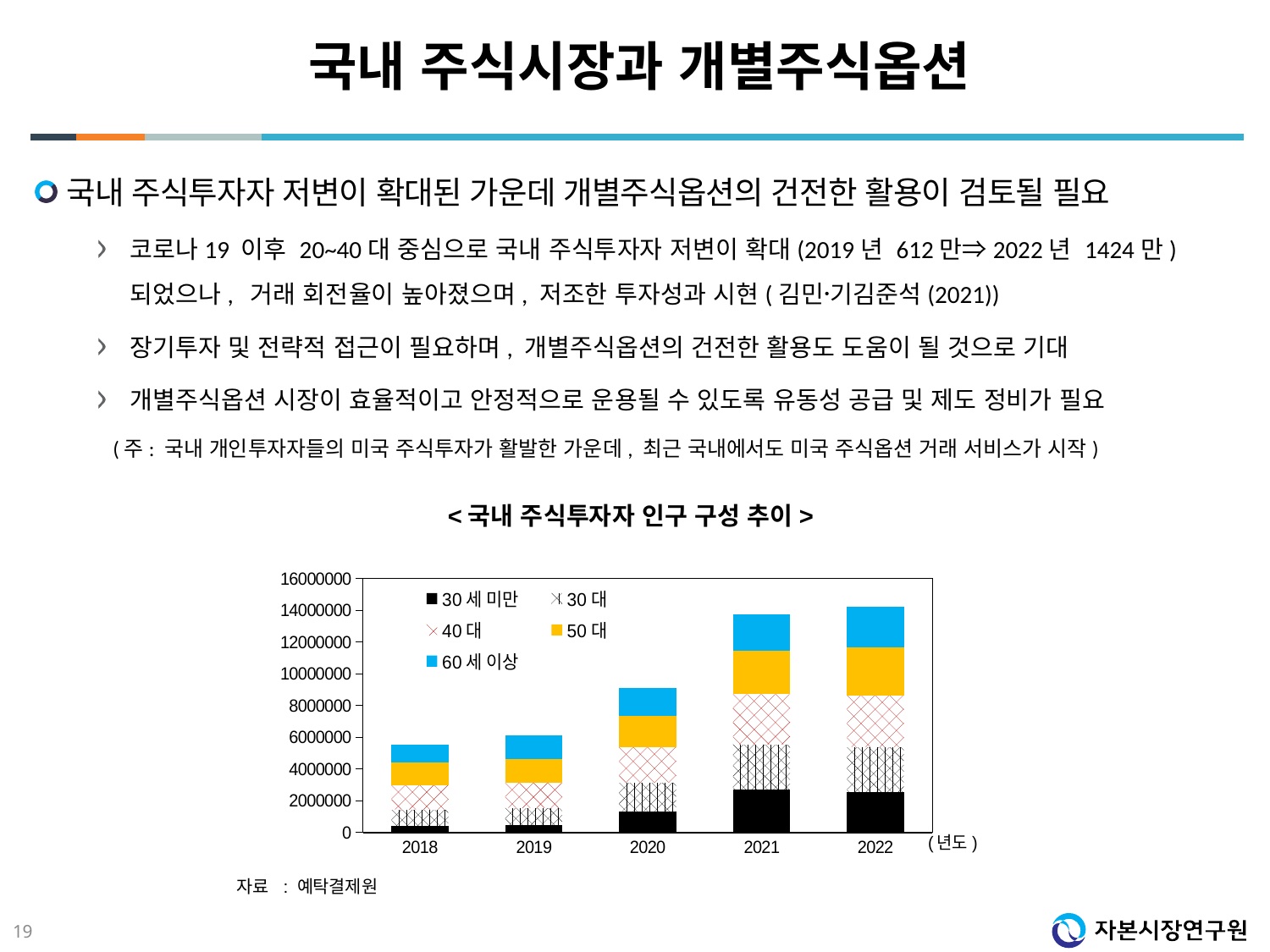
Which year has the lowest total stacked bar? 2018 What kind of chart is shown on the slide? Stacked bar chart Is the total value for 2020 greater or less than 8000000? greater Which series is shown in black in the chart's legend? 30세 미만 Which year has the highest total stacked bar? 2022 Do the total bar heights rise or fall from 2018 to 2022? Rise Is the total value for 2018 greater or less than 6000000? less What is the title of the chart? 국내 주식투자자 인구 구성 추이 Which year has a larger total bar, 2020 or 2021? 2021 Is the total value for 2021 greater or less than 12000000? greater How many series does the chart's legend list? 5 How many years are shown on the x axis of the chart? 5